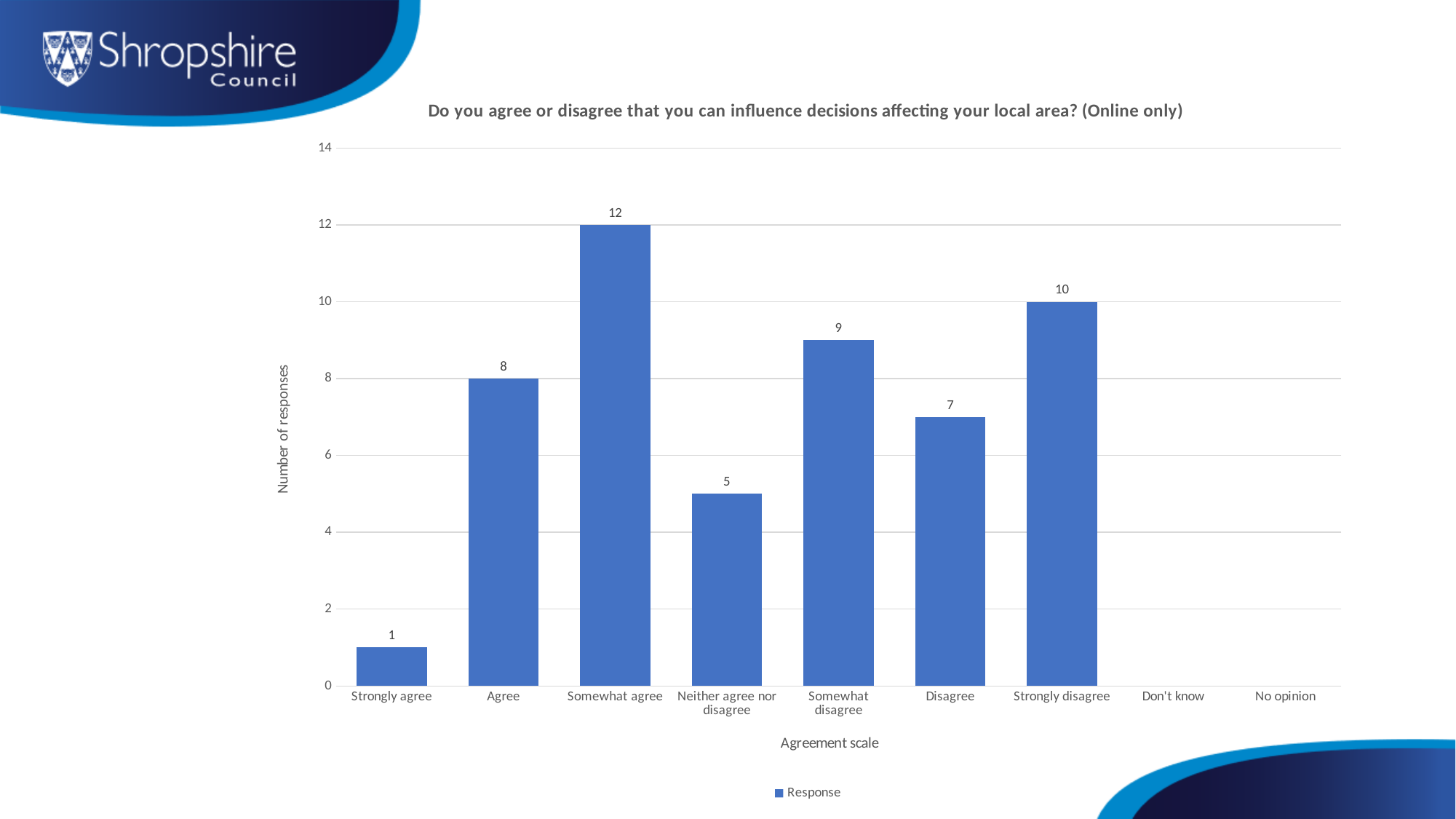
Which category has the highest number of responses? Somewhat agree What is the number of responses for Strongly disagree? 10 Is the value for Strongly disagree greater or less than 8? greater Which has more responses, Somewhat disagree or Disagree? Somewhat disagree How many series does the legend list? 1 What is the label of the y axis? Number of responses How many categories are shown on the x axis? 9 What is the difference in responses between Somewhat agree and Agree? 4 Which category with a visible bar has the lowest number of responses? Strongly agree What is the number of responses for Neither agree nor disagree? 5 What is the number of responses for Somewhat agree? 12 What kind of chart is shown on the slide? Bar chart